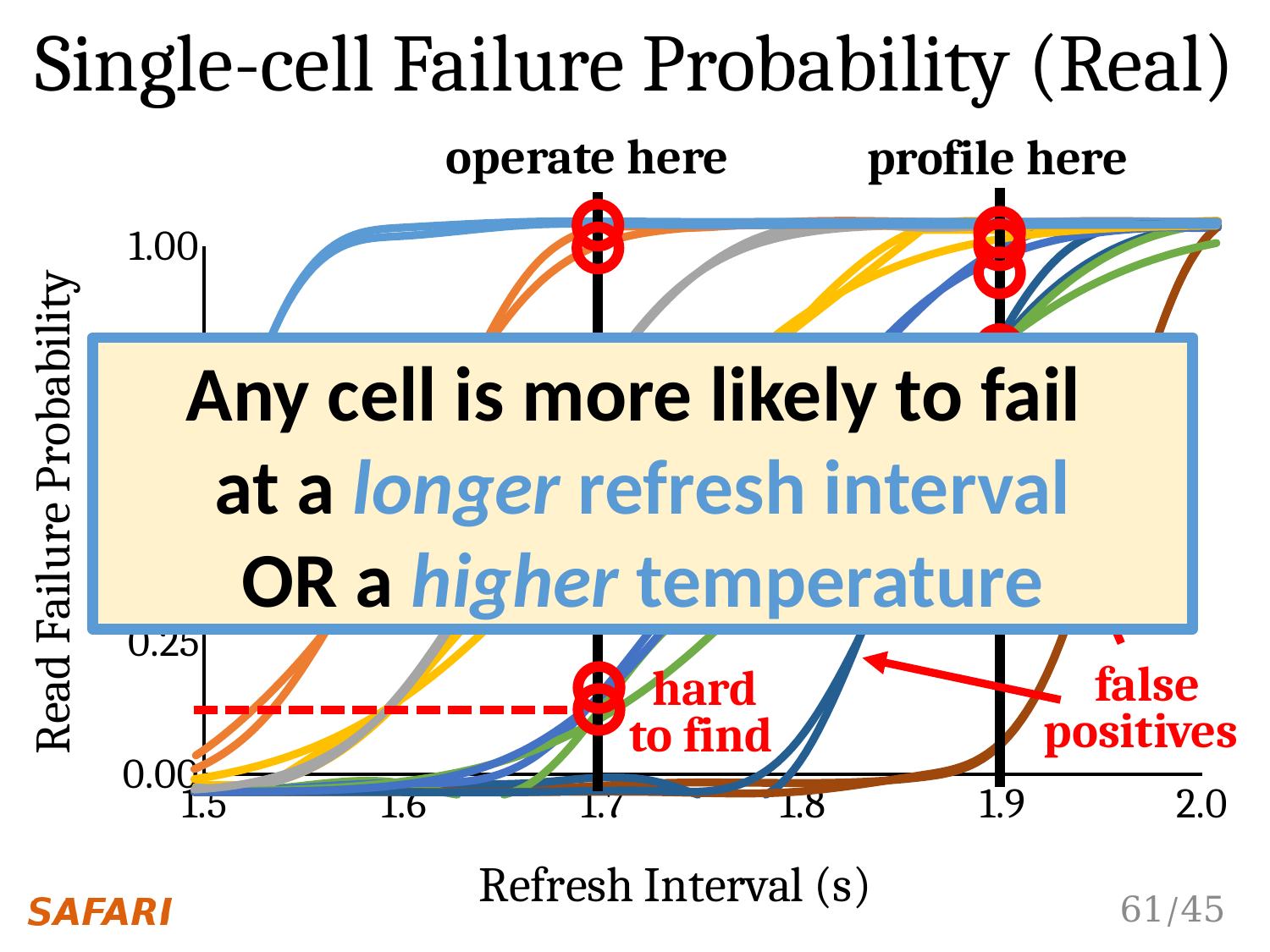
At a refresh interval of 1.7 s, is the value of the light blue curve greater or less than 0.25? greater What is the label of the x axis? Refresh Interval (s) How many tick labels are shown on the x axis? 6 What is the title of the chart? Single-cell Failure Probability (Real) What kind of chart is shown on the slide? line chart At which refresh interval is the vertical line labelled "operate here" drawn? 1.7 At which refresh interval is the vertical line labelled "profile here" drawn? 1.9 What is the lowest tick value shown on the x axis? 1.5 What is the highest tick value shown on the y axis? 1.00 At a refresh interval of 1.9 s, is the value of the light blue curve greater or less than 0.25? greater At a refresh interval of 1.7 s, is the value of the brown curve greater or less than 0.25? less Do the curves rise or fall as the refresh interval increases along the x axis? rise